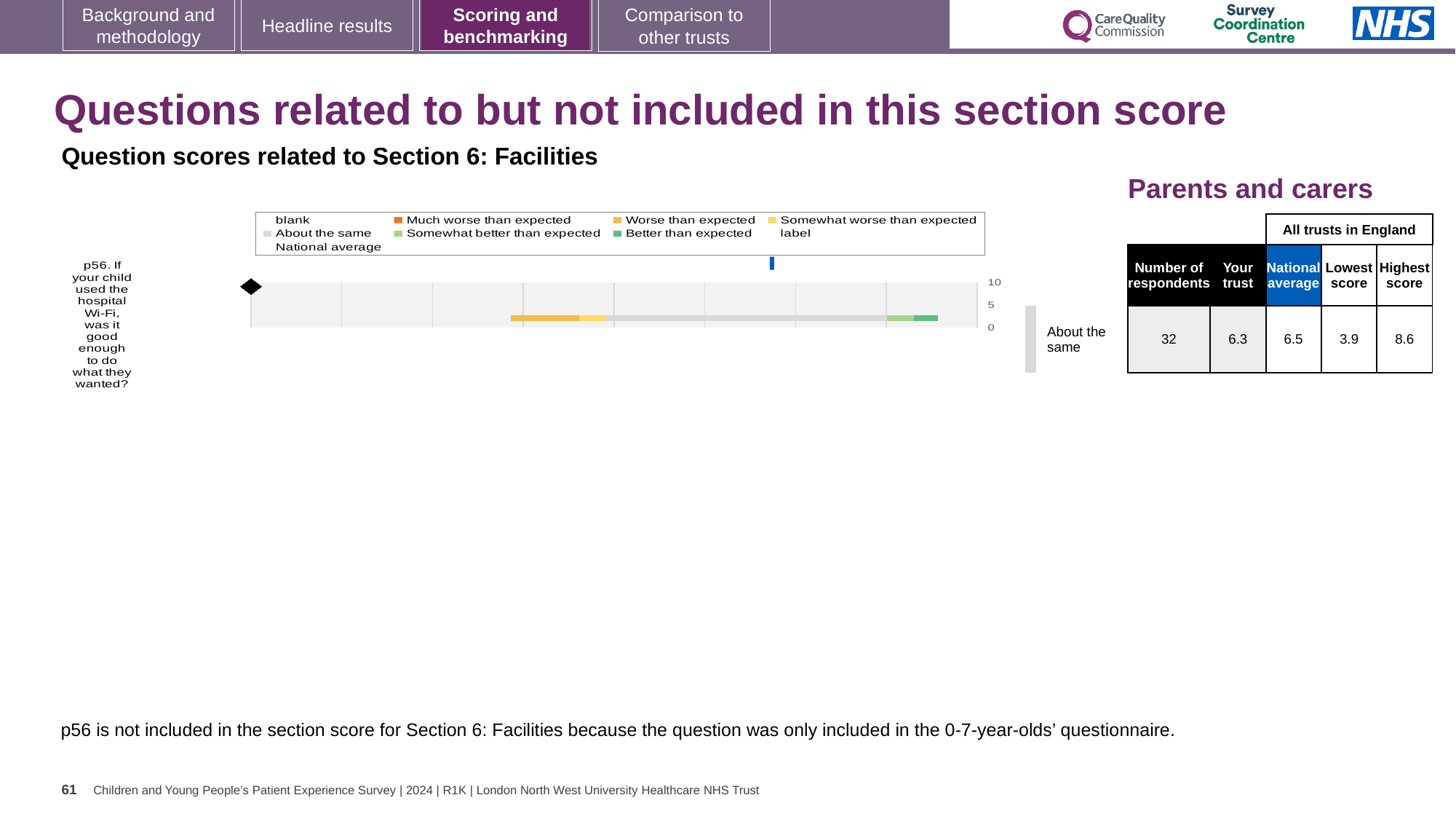
What is the lowest score among all trusts in England for p56? 3.9 What is the national average score for p56 in the table beside the chart? 6.5 What is the 'Your trust' score for p56 in the table beside the chart? 6.3 What kind of chart is shown for question p56? bar chart What colour does the legend use for 'Better than expected'? green How many respondents answered p56 according to the table beside the chart? 32 Which benchmarking band is the trust's result for p56 placed in? About the same Which is larger for p56, the 'Your trust' score or the national average? National average What is the highest score among all trusts in England for p56? 8.6 How many questions are plotted in the chart? 1 What is the highest value shown on the chart's axis? 10 What is the difference between the highest and lowest scores for p56 across all trusts in England? 4.7